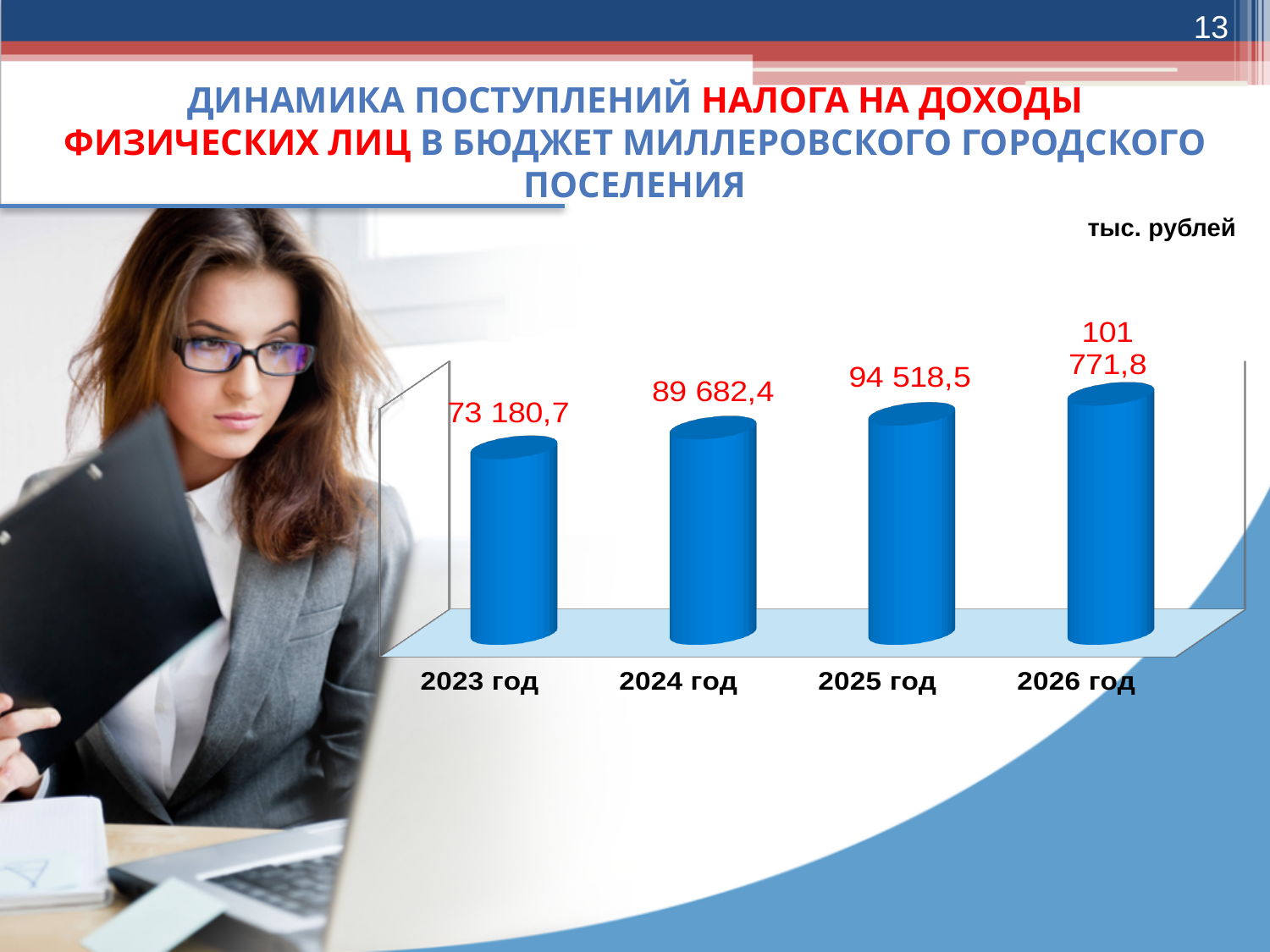
How many years are shown on the chart? 4 Which is larger, the value for 2025 год or the value for 2024 год? 2025 год Which year has the highest value? 2026 год Do the values rise or fall from 2023 год to 2026 год? Rise What is the value for 2023 год? 73 180,7 What is the difference between the values for 2026 год and 2025 год? 7 253,3 What kind of chart is shown on the slide? Bar chart What is the value for 2024 год? 89 682,4 What is the value for 2025 год? 94 518,5 What is the value for 2026 год? 101 771,8 Which year has the lowest value? 2023 год What is the difference between the values for 2024 год and 2023 год? 16 501,7